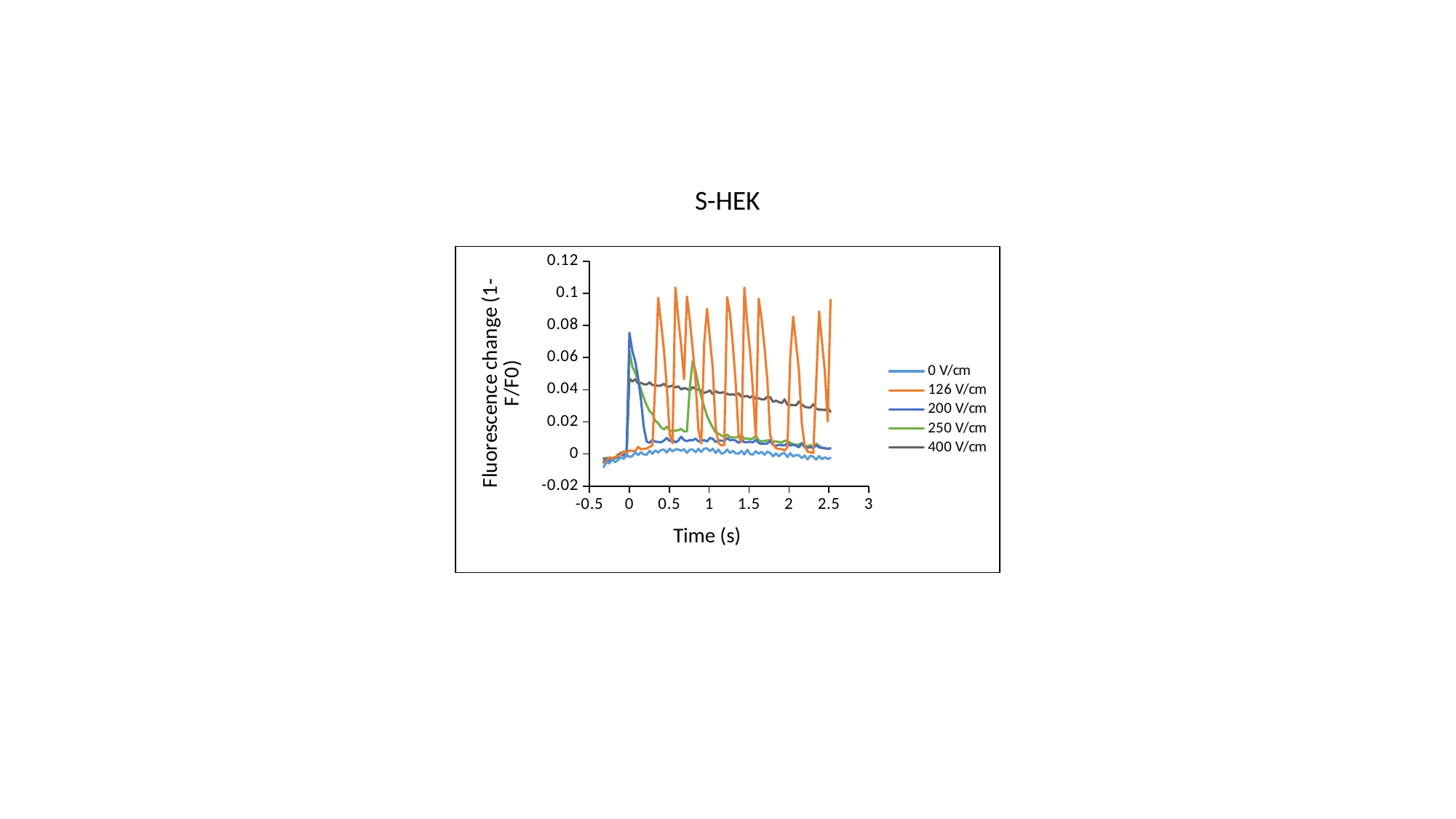
Is the value of the 400 V/cm series at 0.5 s greater or less than 0.02? greater What kind of chart is shown on the slide? line chart Does the 400 V/cm series rise or fall between 0 s and 2.5 s? fall What is the label of the x axis? Time (s) Which series stays lowest across the whole time range? 0 V/cm What is the title of the chart? S-HEK How many series does the legend list? 5 Is the value of the 0 V/cm series at 1 s greater or less than 0.02? less Which series has the higher peak, 200 V/cm or 250 V/cm? 200 V/cm Which series reaches the highest peak fluorescence change? 126 V/cm Is the highest peak of the 126 V/cm series greater or less than 0.08? greater